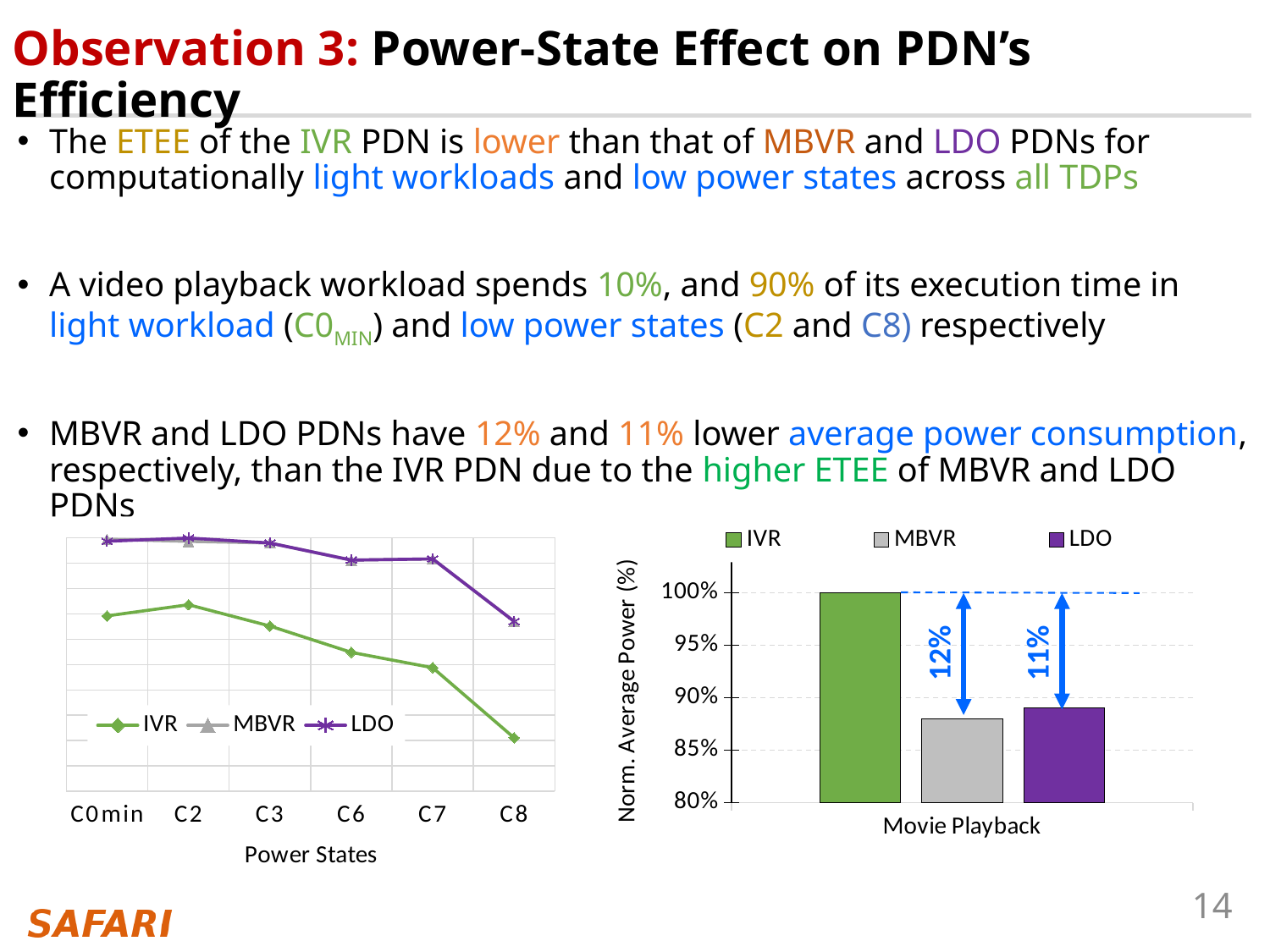
In the right bar chart, which PDN has the highest normalized average power? IVR In the right bar chart, by what percentage is LDO's average power lower than IVR's, according to the label? 11% How many power states are shown on the x axis of the left line chart? 6 In the right bar chart, is the value for MBVR greater or less than 90%? less In the left line chart, does the IVR series rise or fall from C2 to C8? fall In the right bar chart, what is the label on the y axis? Norm. Average Power (%) In the left line chart, which power state has the lowest IVR value? C8 What type of chart is the right chart labelled Movie Playback? bar chart What type of chart is the left chart with the x axis labelled Power States? line chart In the left line chart, which series has the lowest values across the power states? IVR How many series does the legend of the left line chart list? 3 In the right bar chart, what is the normalized average power for IVR? 100%